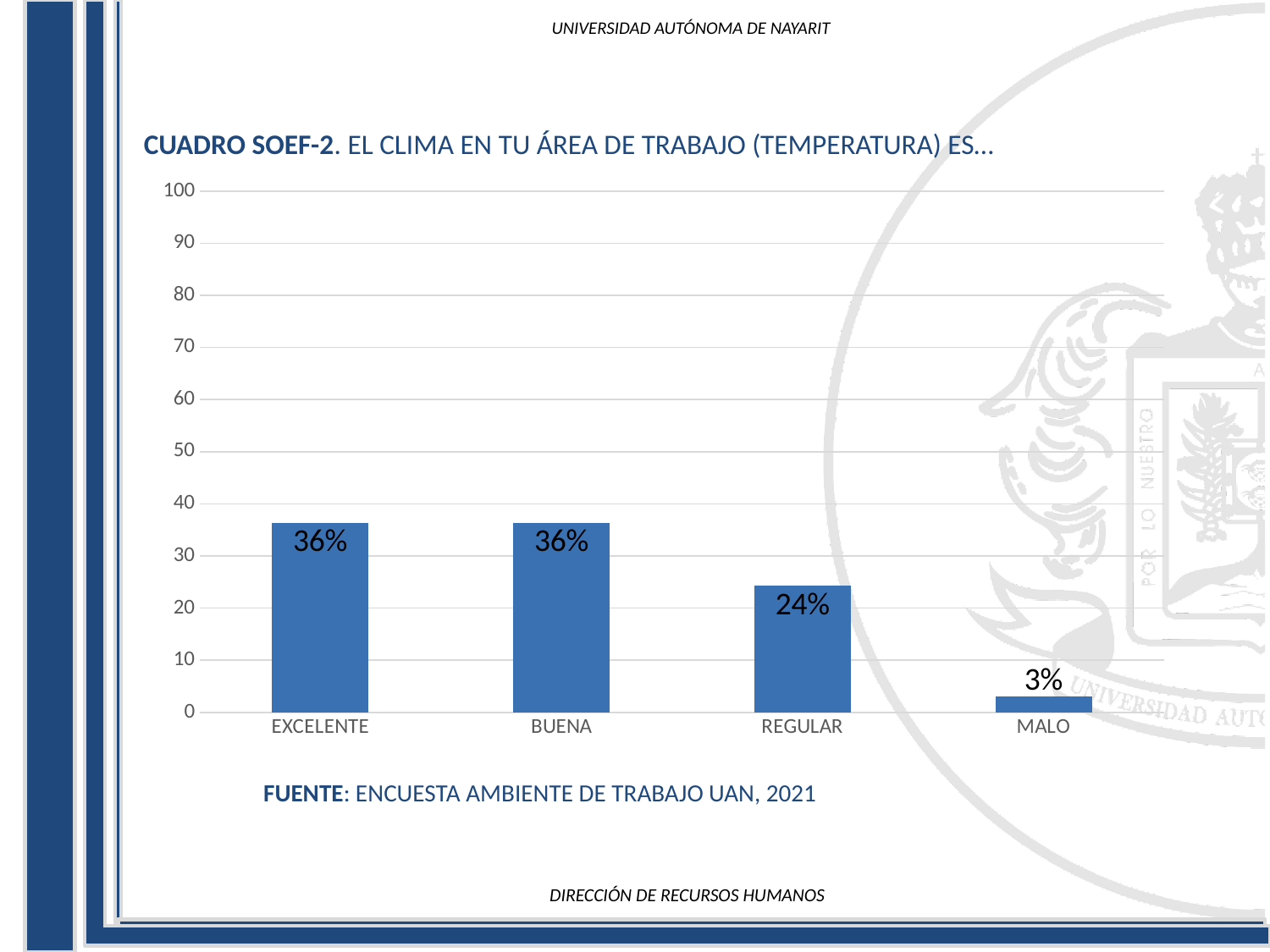
What is the value for EXCELENTE? 36% Which category has the lowest value? MALO What kind of chart is shown on the slide? bar chart What is the difference between the values for EXCELENTE and REGULAR? 12% Which is larger, the value for REGULAR or the value for MALO? REGULAR What is the value for MALO? 3% What is the difference between the values for REGULAR and MALO? 21% What is the value for BUENA? 36% How many categories are shown on the x axis? 4 Is the value for REGULAR greater or less than 30? less What is the source cited below the chart? ENCUESTA AMBIENTE DE TRABAJO UAN, 2021 What is the value for REGULAR? 24%